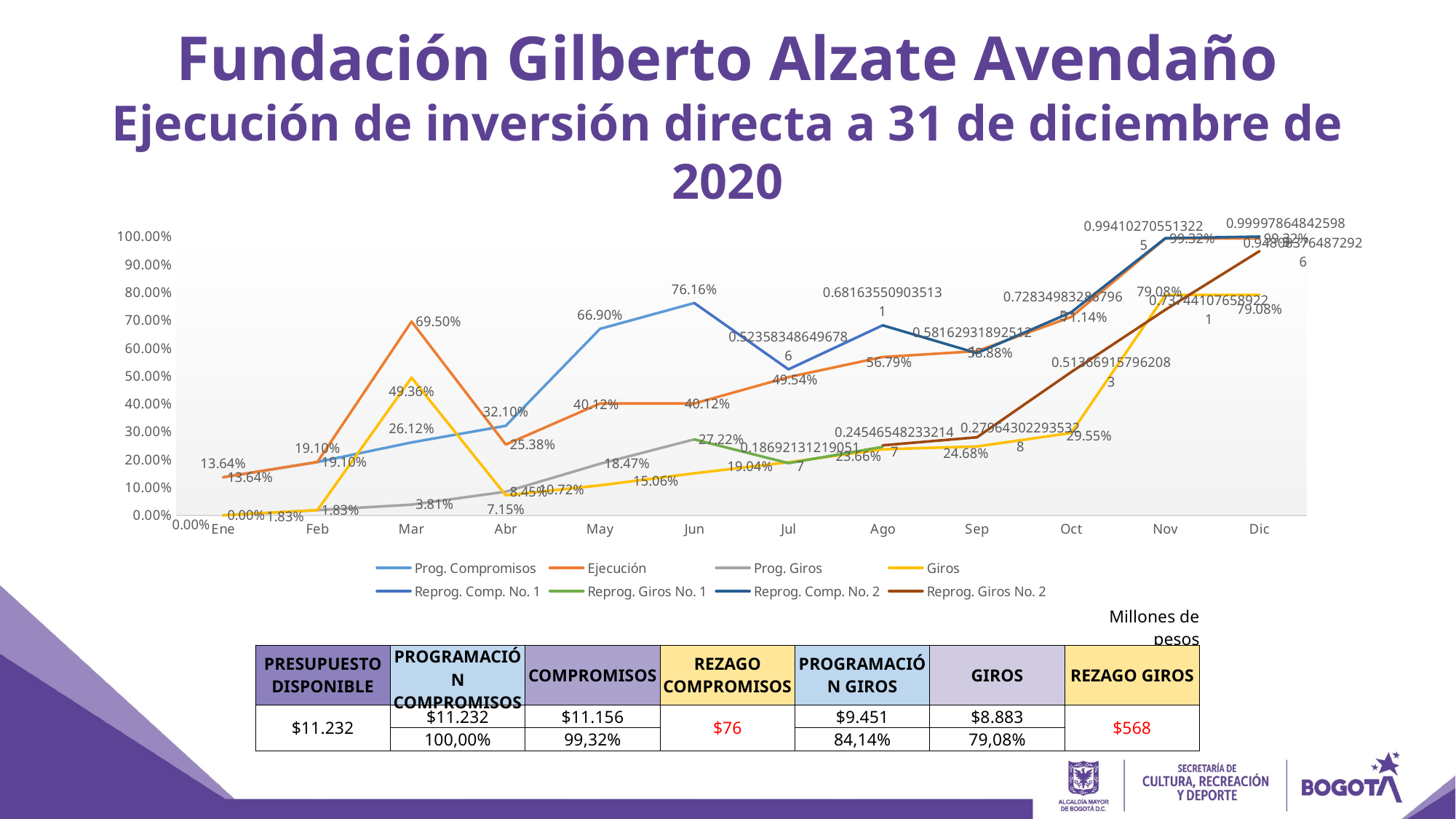
What is the Prog. Compromisos value for Jun? 76.16% Is the Reprog. Comp. No. 2 value for Oct greater or less than 90%? less How many months are shown along the x axis of the chart? 12 What is the Giros value for Nov? 79.08% What is the Prog. Giros value for May? 18.47% In which month is the Ejecución value lowest? Ene What is the Ejecución value for Mar? 69.50% What kind of chart is shown on the slide? line chart How many series does the chart legend list? 8 In Mar, which is larger: the Ejecución value or the Giros value? Ejecución What is the difference between the Ejecución values for Mar and Abr? 44.12% Do the Giros values rise or fall from Abr to Dic? rise